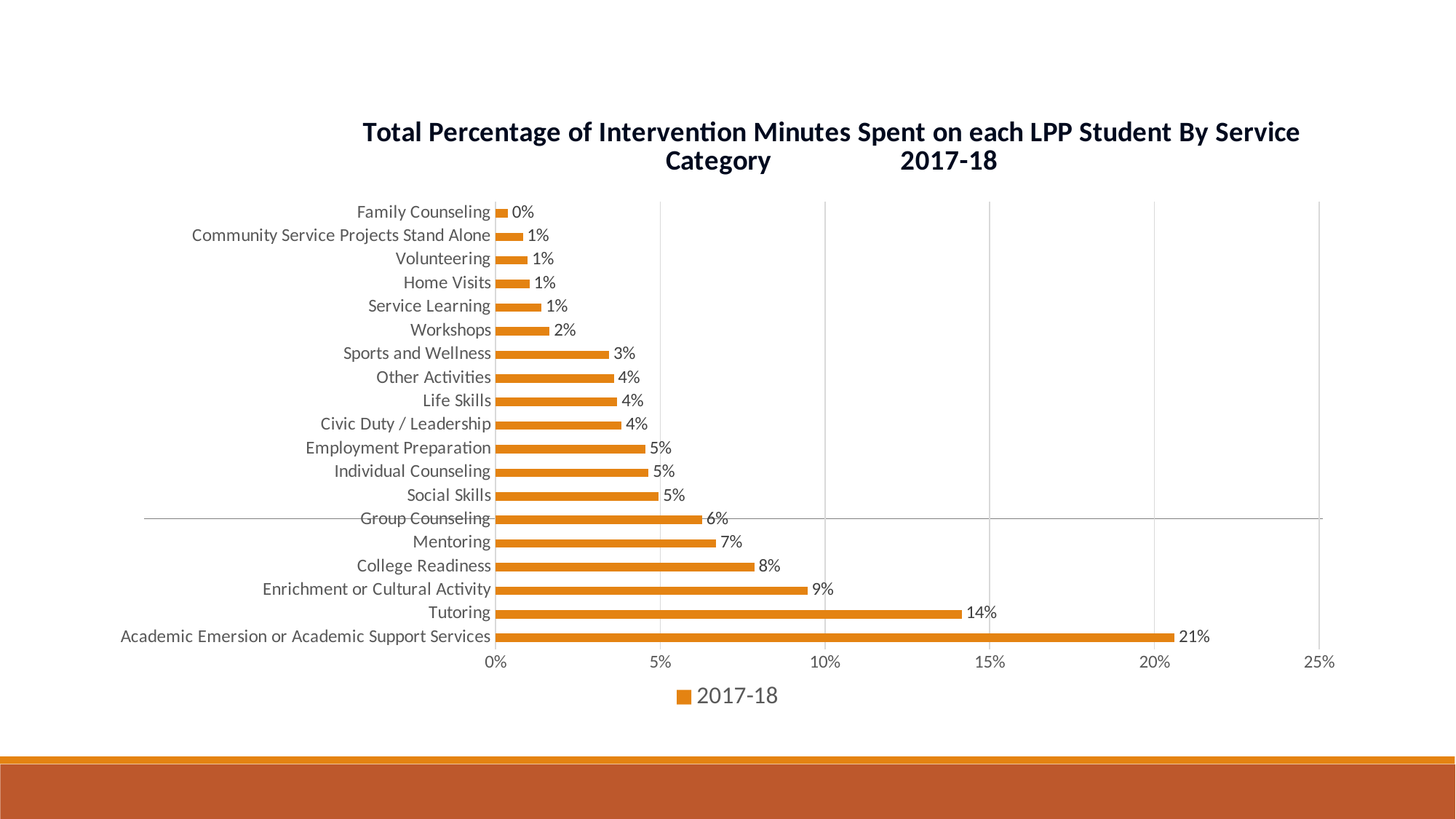
Is the value for Academic Emersion or Academic Support Services greater or less than 20%? greater What is the value for Enrichment or Cultural Activity? 9% What series name is shown in the legend? 2017-18 What kind of chart is shown on the slide? bar chart Which is larger, the value for College Readiness or the value for Group Counseling? College Readiness What is the difference between the values for Academic Emersion or Academic Support Services and Tutoring? 7% Which category has the highest value? Academic Emersion or Academic Support Services Which category has the lowest value? Family Counseling How many categories are shown on the chart? 19 What is the value for Mentoring? 7% What is the value for Tutoring? 14% How many series does the legend list? 1